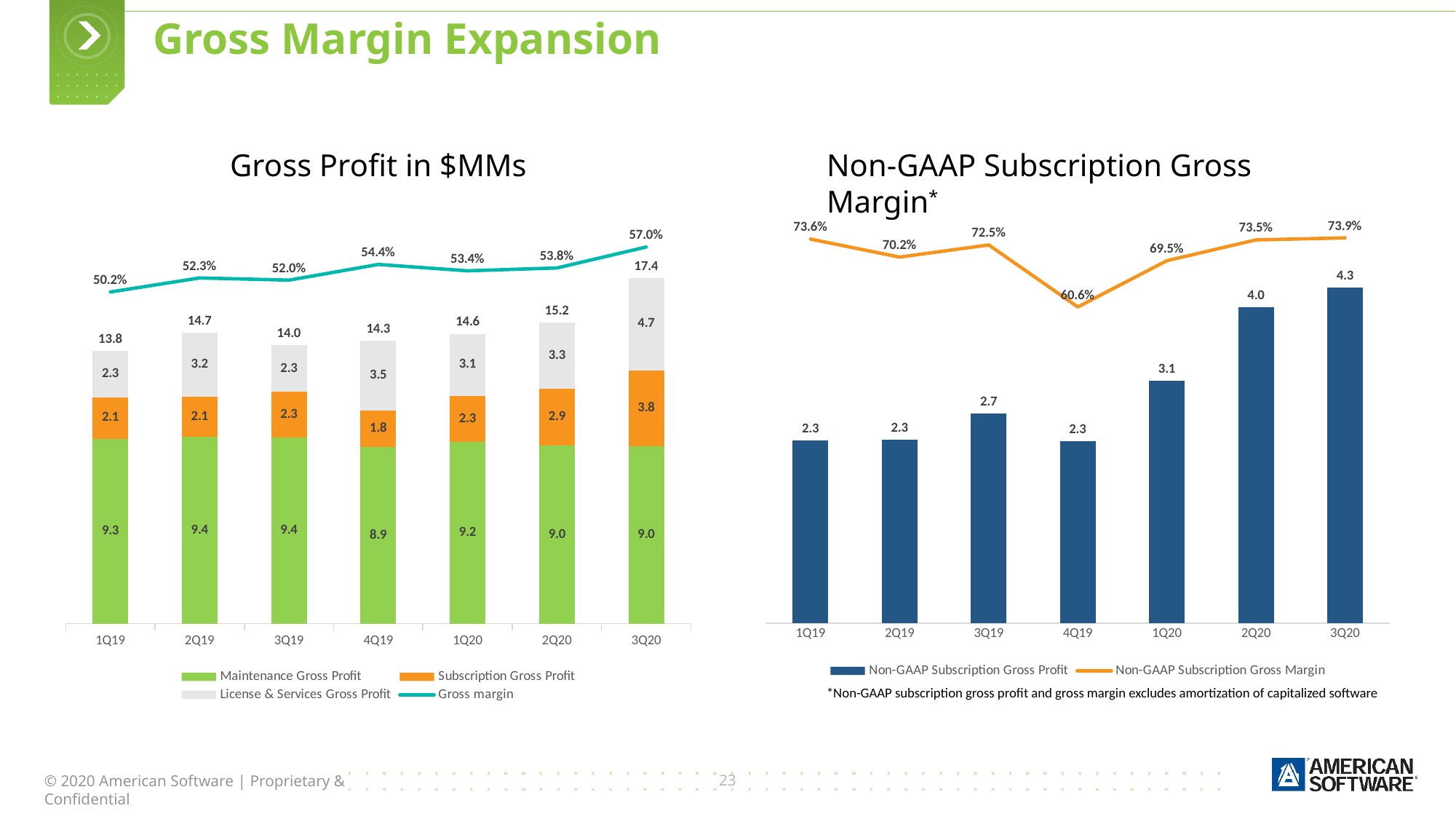
In the 'Non-GAAP Subscription Gross Margin' chart, which quarter has the lowest Non-GAAP Subscription Gross Margin? 4Q19 In the 'Non-GAAP Subscription Gross Margin' chart, what is the Non-GAAP Subscription Gross Margin for 3Q20? 73.9% In the 'Gross Profit in $MMs' chart, how many series does the legend list? 4 In the 'Gross Profit in $MMs' chart, which quarter has the highest total gross profit? 3Q20 In the 'Gross Profit in $MMs' chart, what is the Maintenance Gross Profit for 1Q19? 9.3 In the 'Gross Profit in $MMs' chart, what is the difference between Subscription Gross Profit in 3Q20 and 2Q20? 0.9 In the 'Non-GAAP Subscription Gross Margin' chart, what is the Non-GAAP Subscription Gross Profit for 1Q20? 3.1 In the 'Gross Profit in $MMs' chart, what is the total gross profit for 2Q20? 15.2 In the 'Non-GAAP Subscription Gross Margin' chart, does the Non-GAAP Subscription Gross Profit rise or fall from 4Q19 to 3Q20? rise In the 'Non-GAAP Subscription Gross Margin' chart, is the Non-GAAP Subscription Gross Profit larger in 2Q20 or 3Q19? 2Q20 In the 'Non-GAAP Subscription Gross Margin' chart, how many quarters are shown on the x axis? 7 In the 'Gross Profit in $MMs' chart, what is the Gross margin for 3Q20? 57.0%